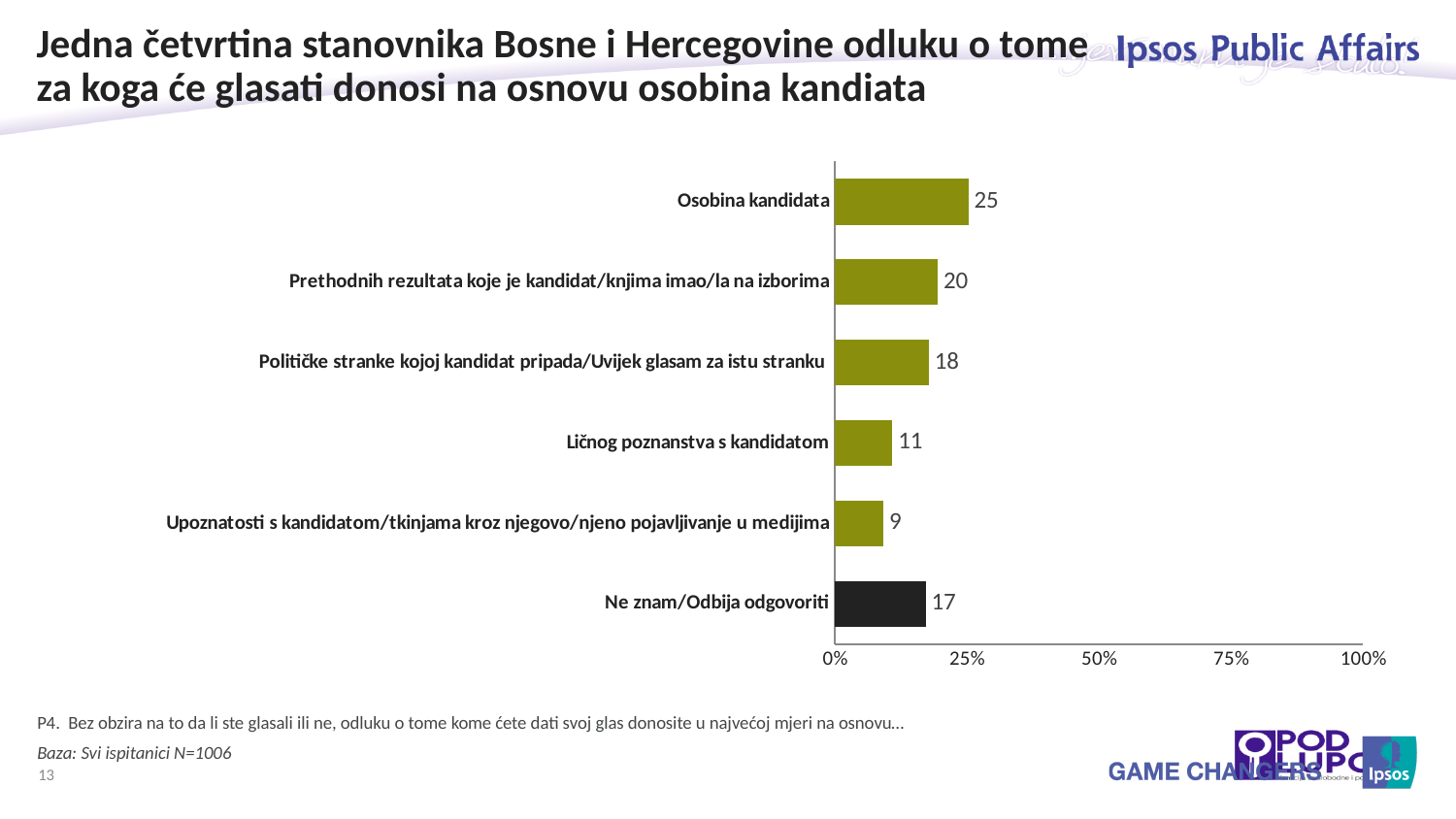
What is the value for "Osobina kandidata"? 25 Which category has the highest value? Osobina kandidata What is the difference between the values for "Osobina kandidata" and "Prethodnih rezultata koje je kandidat/knjima imao/la na izborima"? 5 What is the highest value shown on the x axis? 100% Which bar is coloured differently (dark) from the others? Ne znam/Odbija odgovoriti Which is larger: the value for "Političke stranke kojoj kandidat pripada/Uvijek glasam za istu stranku" or for "Ne znam/Odbija odgovoriti"? Političke stranke kojoj kandidat pripada/Uvijek glasam za istu stranku Which category has the lowest value? Upoznatosti s kandidatom/tkinjama kroz njegovo/njeno pojavljivanje u medijima How many categories are shown in the chart? 6 What kind of chart is shown on the slide? bar chart Is the value for "Osobina kandidata" greater or less than 50%? less What is the value for "Ličnog poznanstva s kandidatom"? 11 What is the value for "Ne znam/Odbija odgovoriti"? 17